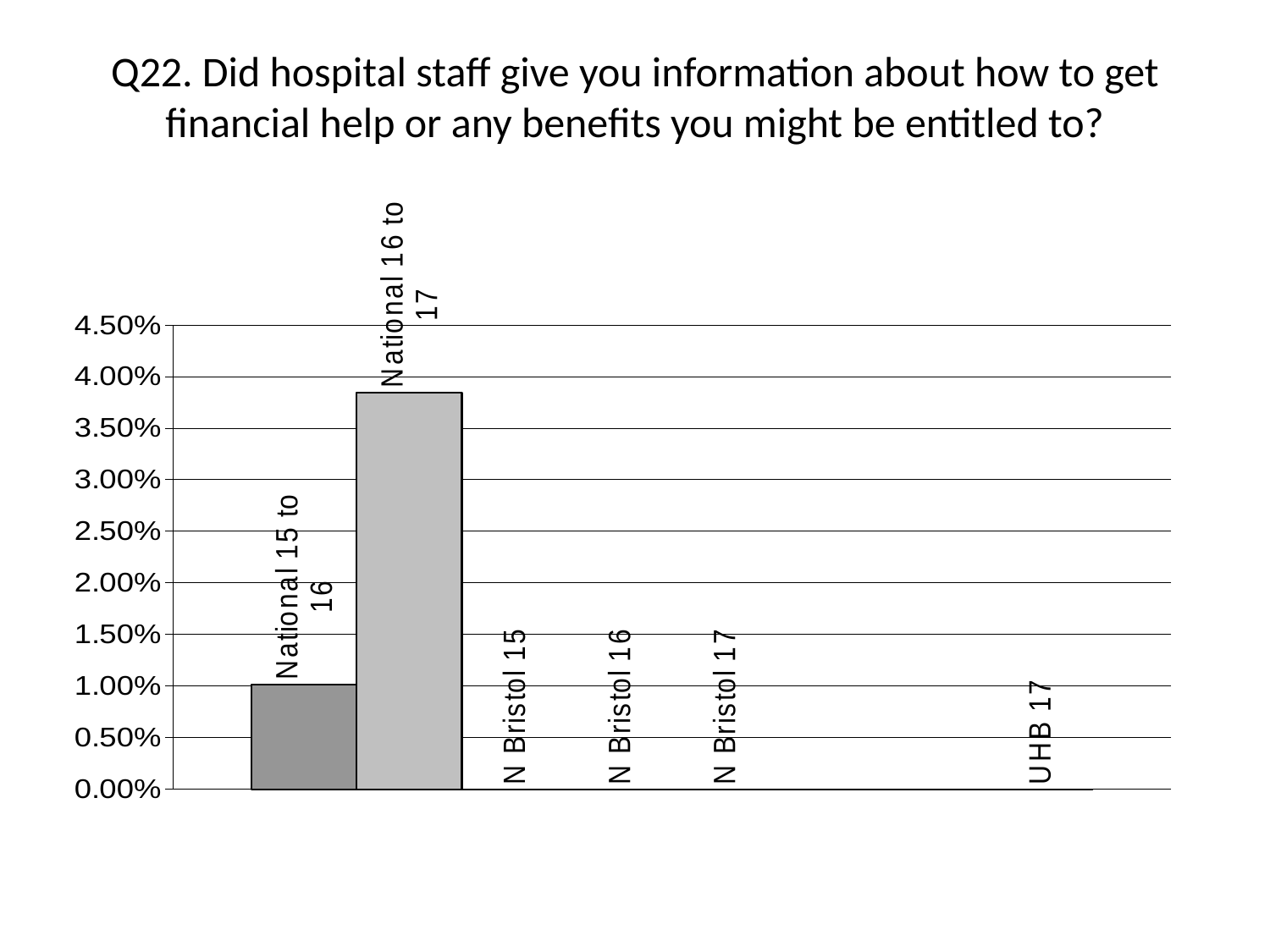
Is the value for National 15 to 16 greater or less than 0.50%? greater What kind of chart is shown on the slide? bar chart Is the value for National 15 to 16 greater or less than 2.00%? less Is the value for National 16 to 17 greater or less than 3.50%? greater Which category has the highest value? National 16 to 17 What is the title of the chart? Q22. Did hospital staff give you information about how to get financial help or any benefits you might be entitled to? Which is larger, the value for National 15 to 16 or the value for National 16 to 17? National 16 to 17 What is the highest value shown on the vertical axis? 4.50%